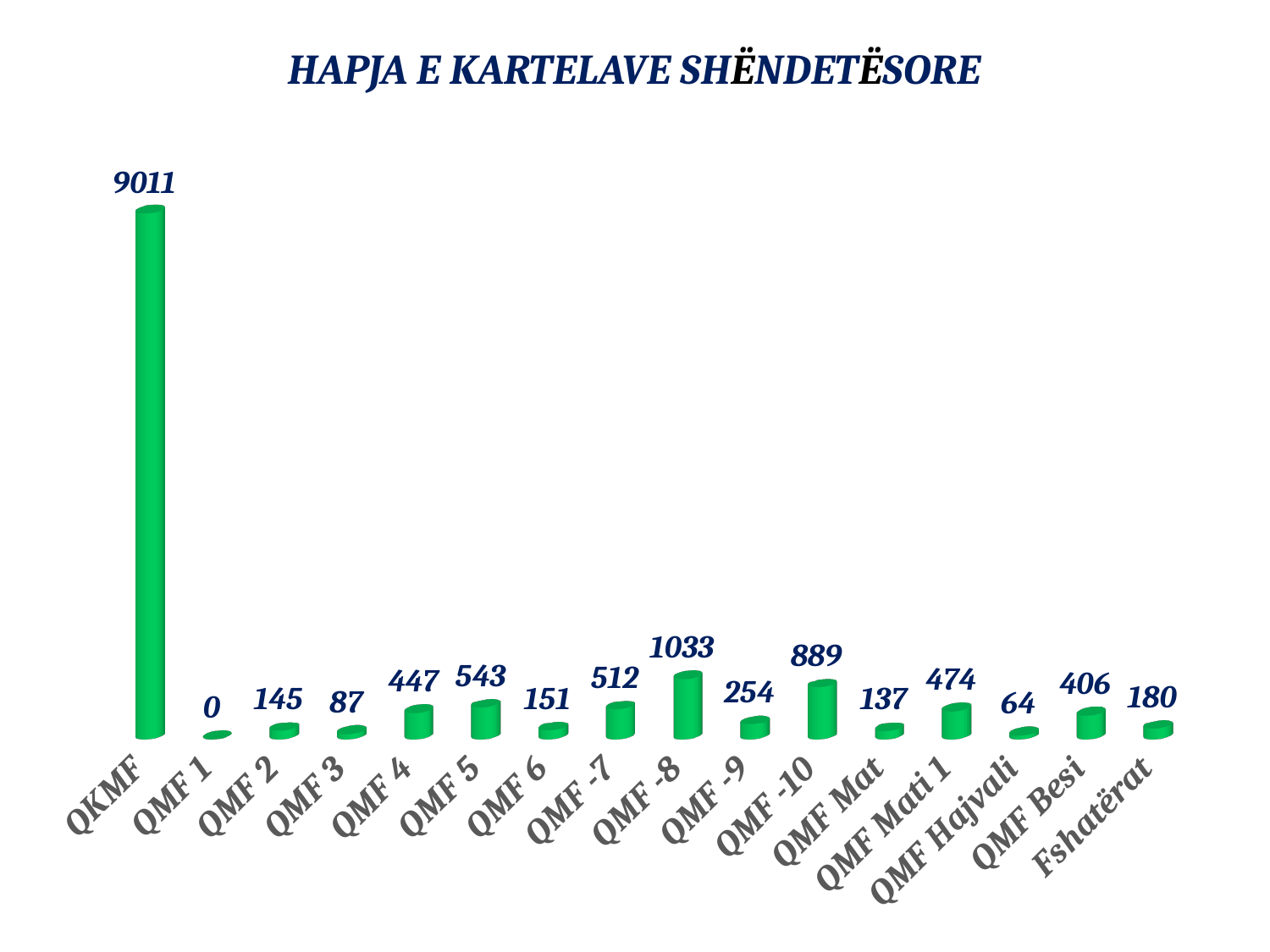
What is the difference between the values for QMF -10 and QMF -9? 635 What colour are the bars in the chart? Green What is the title of the chart? HAPJA E KARTELAVE SHËNDETËSORE Which category has the lowest value? QMF 1 What is the value for QMF -8? 1033 Which is larger, the value for QMF 5 or the value for QMF 4? QMF 5 What is the value for QMF Hajvali? 64 How many categories are shown on the chart? 16 What is the value for QKMF? 9011 What kind of chart is shown on the slide? Bar chart Which category has the highest value? QKMF What is the value for Fshatërat? 180